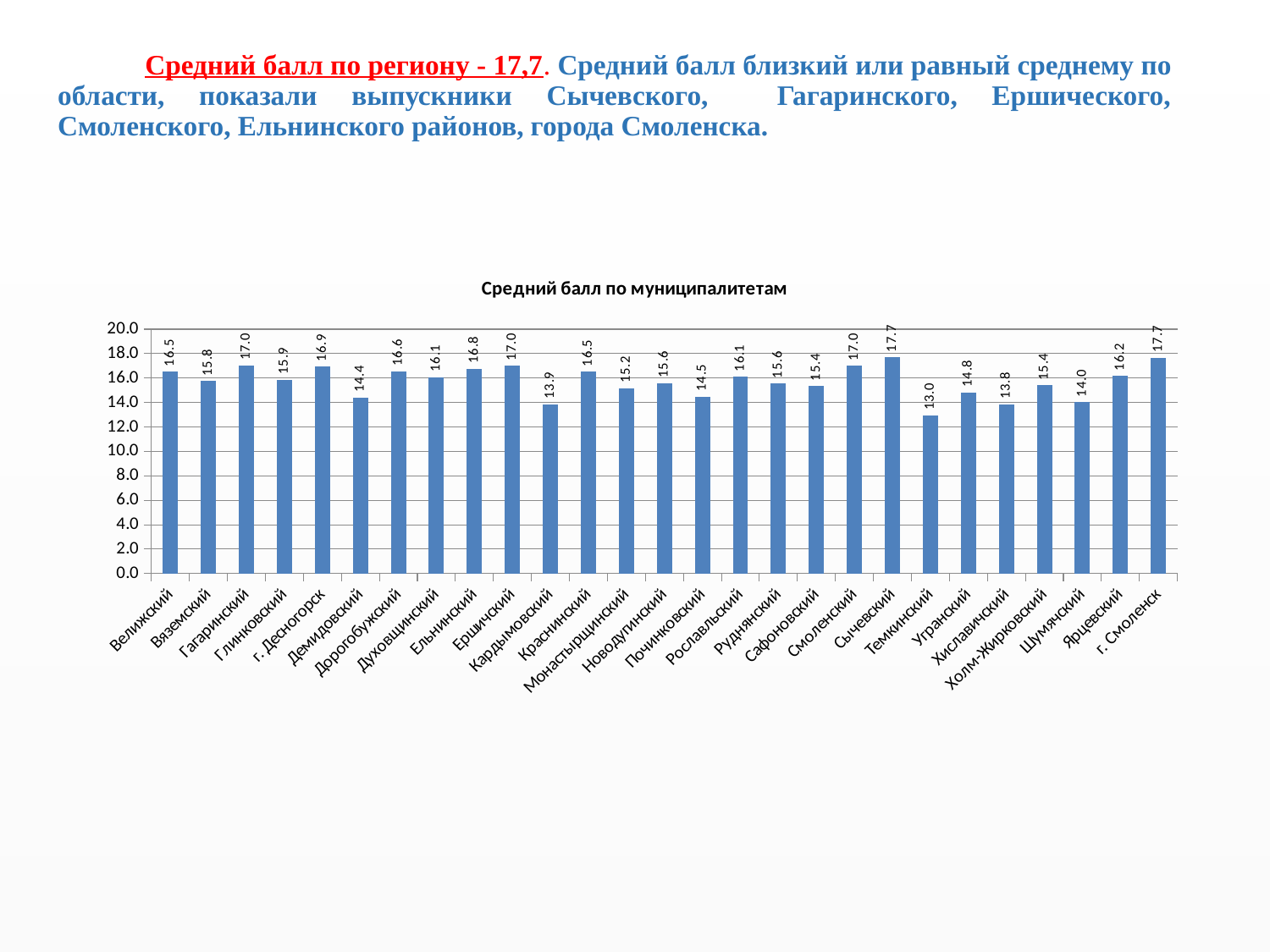
Which is larger, the value for Хиславичский or the value for Ярцевский? Ярцевский What is the value for г. Десногорск? 16.9 Which municipality has the lowest value? Темкинский Which is larger, the value for Ельнинский or the value for Починковский? Ельнинский What is the difference between the values for г. Смоленск and Темкинский? 4.7 What is the value for Холм-Жирковский? 15.4 How many municipalities are shown on the x axis? 27 What is the value for Кардымовский? 13.9 What kind of chart is shown on the slide? Bar chart What is the title of the chart? Средний балл по муниципалитетам What is the value for Темкинский? 13.0 What is the difference between the values for Гагаринский and Демидовский? 2.6